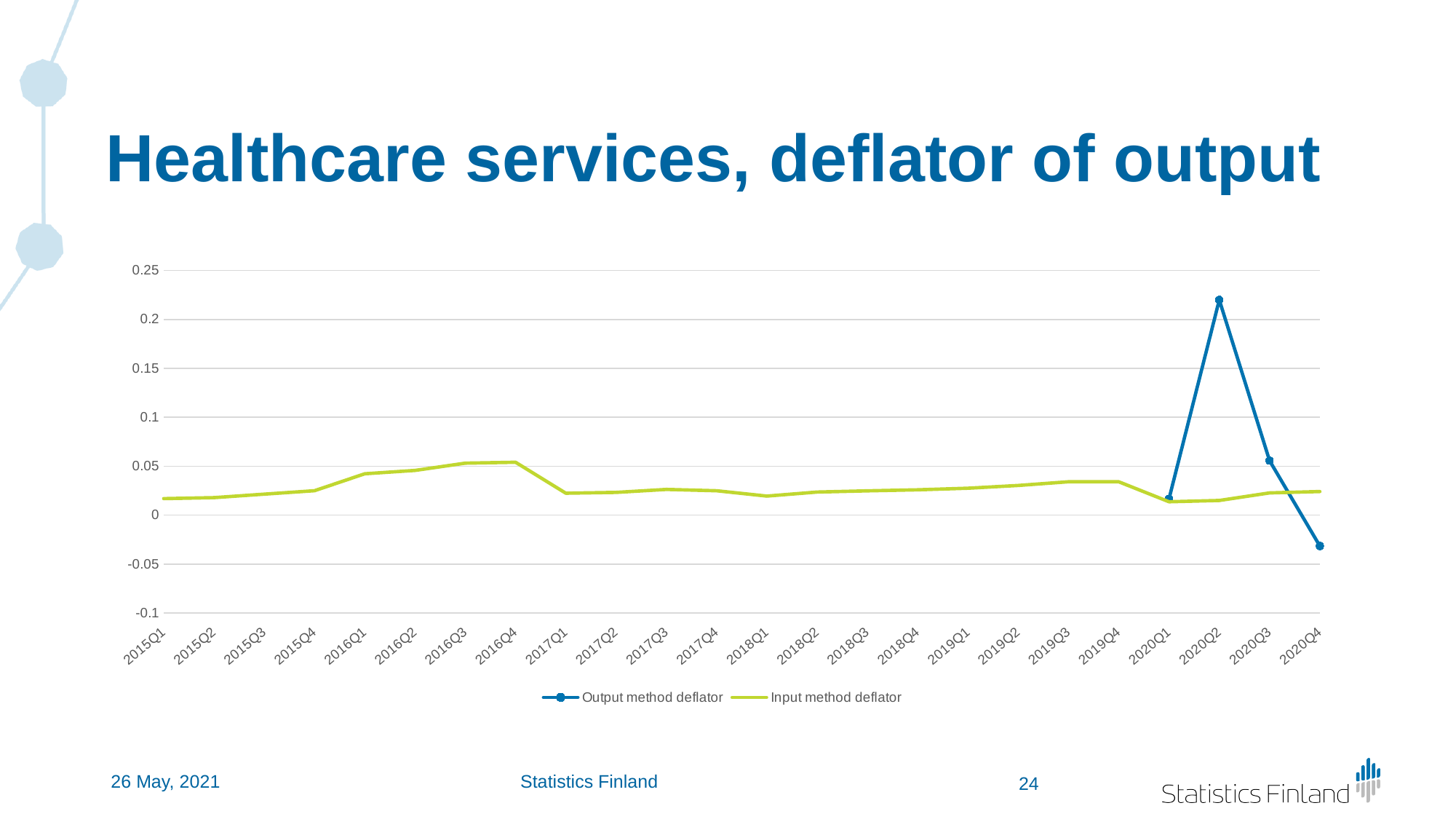
Is the Output method deflator value for 2020Q4 greater or less than 0? less Is the Output method deflator value for 2020Q2 greater or less than 0.2? greater Is the Input method deflator value for 2019Q4 greater or less than 0.05? less What kind of chart is shown on the slide? line chart Does the Output method deflator rise or fall from 2020Q2 to 2020Q4? fall How many quarters are shown on the x axis? 24 In which quarter does the Output method deflator reach its lowest value? 2020Q4 How many series does the legend list? 2 Which series has the larger value in 2020Q2, Output method deflator or Input method deflator? Output method deflator What is the title of the chart on the slide? Healthcare services, deflator of output Which series has the larger value in 2020Q4, Output method deflator or Input method deflator? Input method deflator In which quarter does the Output method deflator reach its highest value? 2020Q2